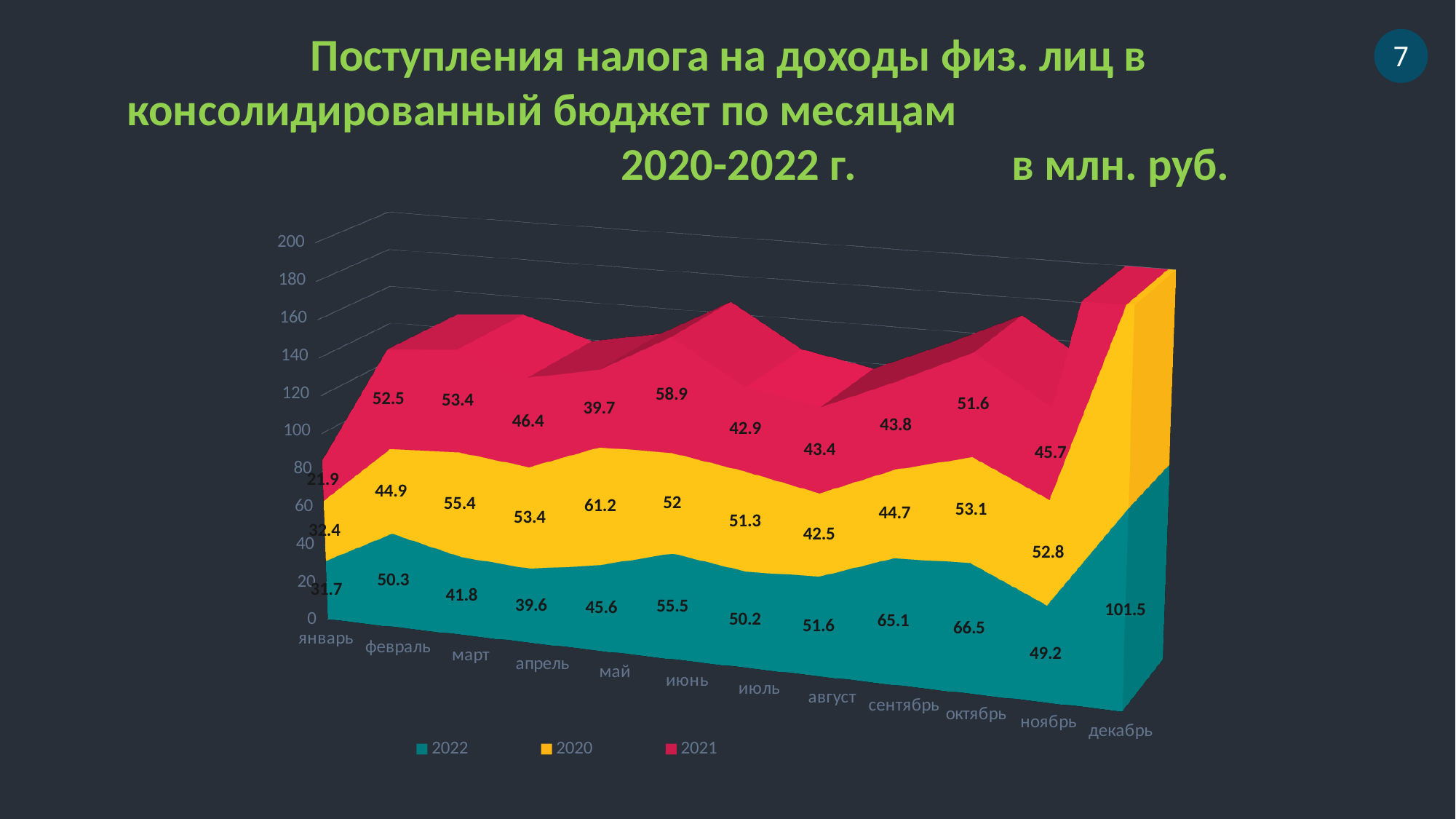
How many months are shown on the x axis? 12 What is the value for 2022 in декабрь? 101.5 Which month has the highest value for the 2022 series? декабрь Which month has the lowest value for the 2022 series? январь How many series does the legend list? 3 Which month has the lowest value for the 2021 series? январь What is the value for 2021 in июнь? 58.9 What kind of chart is shown on the slide? Stacked area chart What is the value for 2020 in май? 61.2 What is the difference between the 2022 values for октябрь and сентябрь? 1.4 Which is larger: the 2020 value for март or the 2022 value for март? 2020 value for март What is the value for 2021 in январь? 21.9